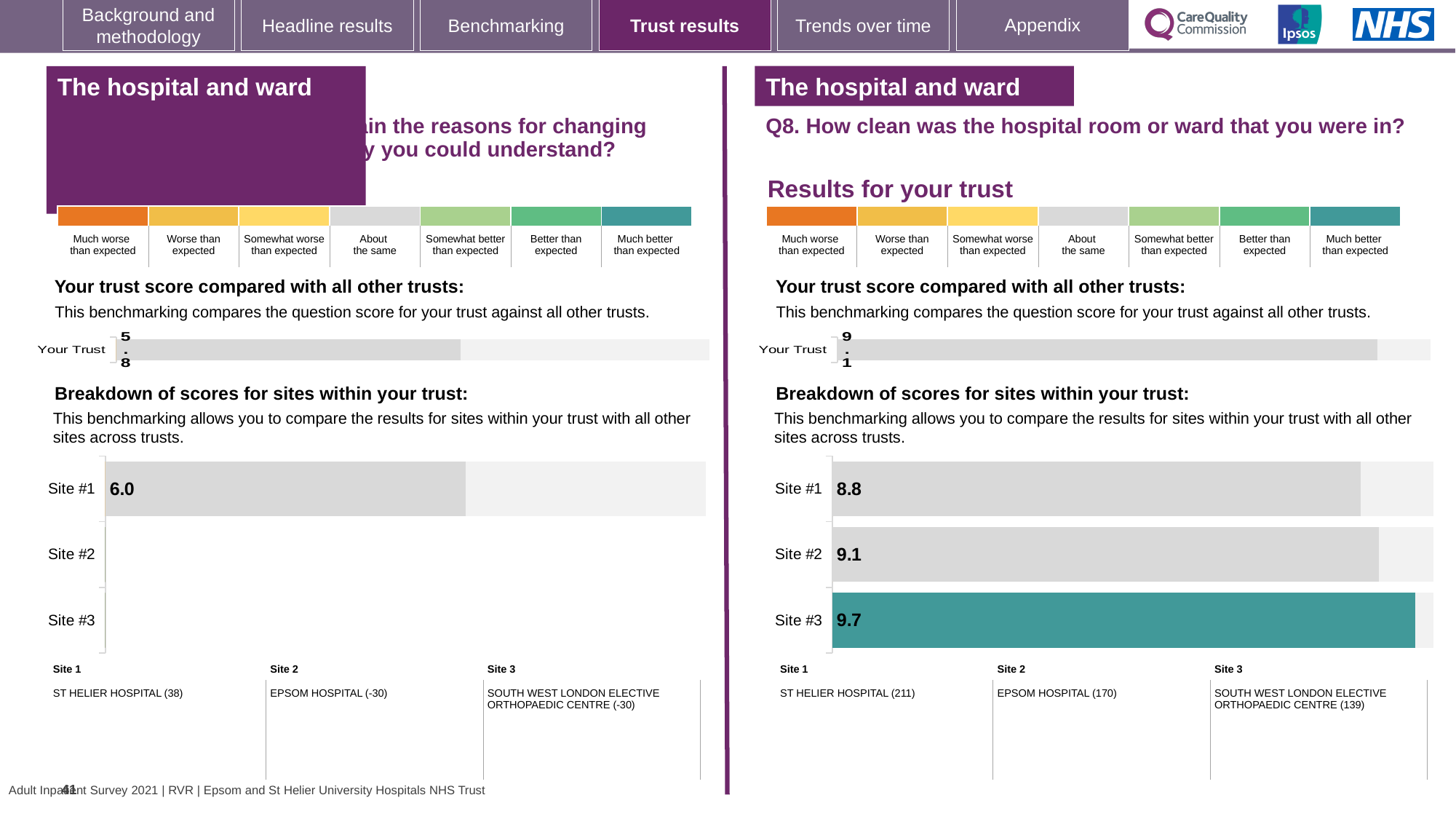
On the right-hand side of the slide (Q8), what is the 'Your Trust' score compared with all other trusts? 9.1 On the right-hand chart for Q8 (how clean was the hospital room or ward), what is the score for Site #3? 9.7 On the left-hand side of the slide, what is the 'Your Trust' score compared with all other trusts? 5.8 On the right-hand chart for Q8, what is the score for Site #2? 9.1 How many sites are listed in the right-hand site breakdown chart for Q8? 3 On the right-hand chart for Q8, what is the difference between the scores for Site #3 and Site #1? 0.9 On the left-hand site breakdown chart, what is the score for Site #1? 6.0 On the right-hand chart for Q8, which site has the lowest score? Site #1 On the right-hand chart for Q8, which has the larger score, Site #2 or Site #3? Site #3 On the right-hand chart for Q8, what is the score for Site #1? 8.8 What type of chart is used for the site breakdown on the right-hand side of the slide? Bar chart On the right-hand chart for Q8, which site has the highest score? Site #3